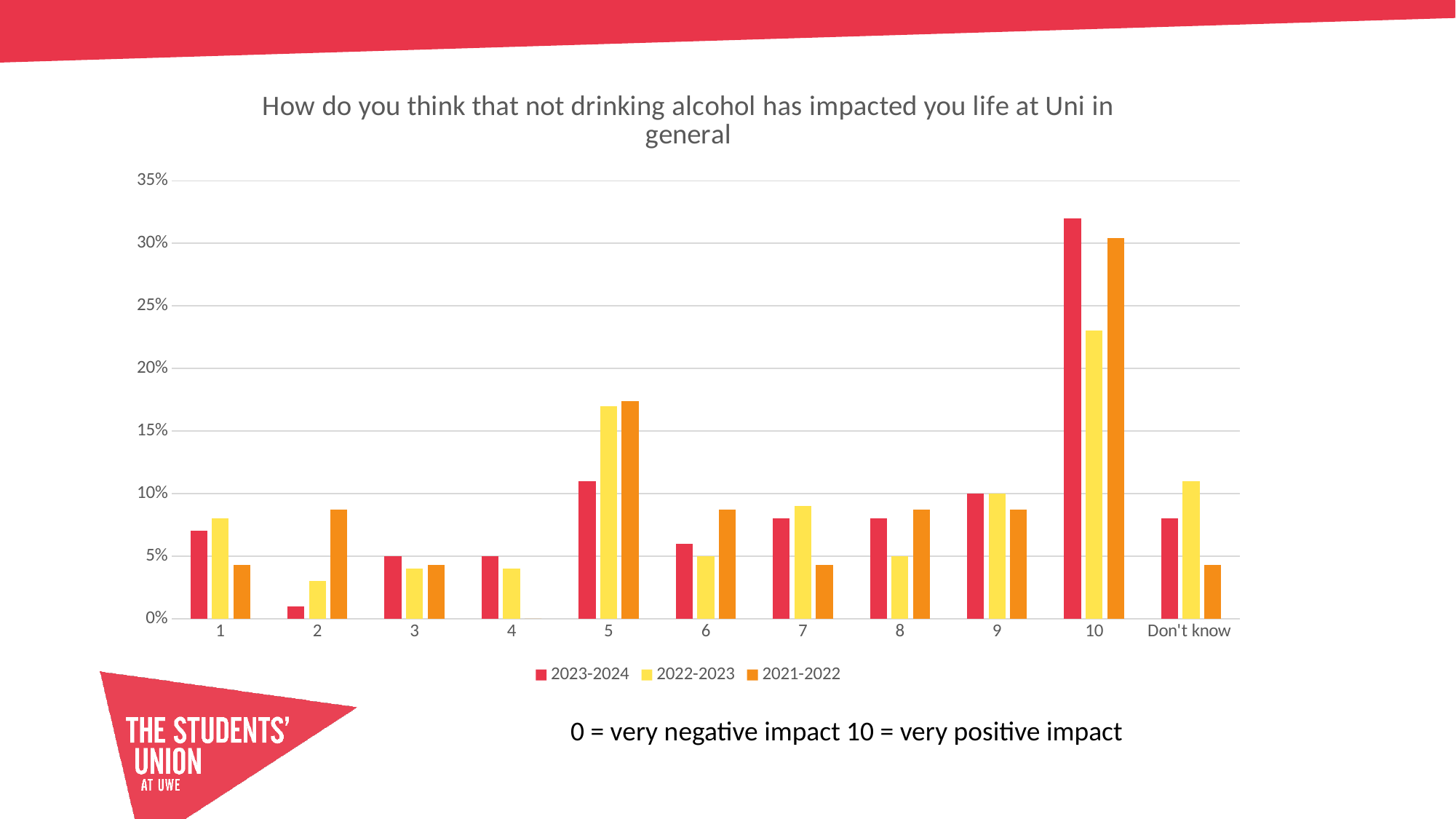
What type of chart is shown on the slide? bar chart Which category has the lowest value for the 2023-2024 series? 2 How many categories are shown along the x axis? 11 Which category has the highest value for the 2022-2023 series? 10 Which category has the highest value for the 2023-2024 series? 10 Is the 2022-2023 value for category 5 greater or less than 15%? greater For category 10, which series has the larger value: 2023-2024 or 2022-2023? 2023-2024 Is the 2022-2023 value for category 10 greater or less than 25%? less How many series does the legend list? 3 Is the 2023-2024 value for category 10 greater or less than 30%? greater What is the title of the chart? How do you think that not drinking alcohol has impacted you life at Uni in general For category 2, which series has the larger value: 2021-2022 or 2023-2024? 2021-2022